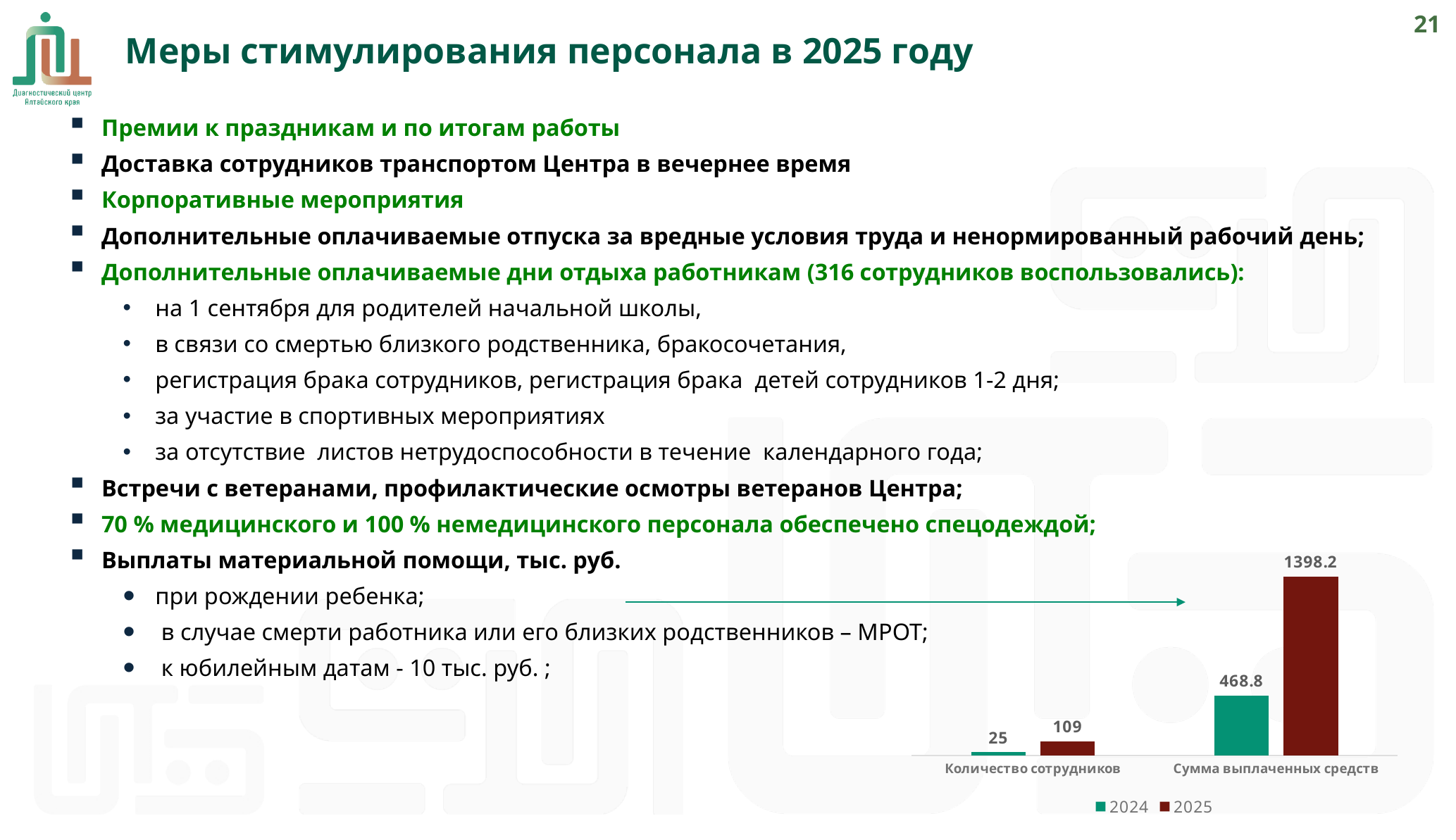
How many series does the chart legend list? 2 Which bar in the chart has the highest value? 2025, Сумма выплаченных средств Which bar in the chart has the lowest value? 2024, Количество сотрудников What is the value for 2024 in the 'Сумма выплаченных средств' category? 468.8 What is the difference between the 2025 and 2024 values for 'Количество сотрудников'? 84 For 'Количество сотрудников', which year has the larger value, 2024 or 2025? 2025 What is the value for 2025 in the 'Количество сотрудников' category? 109 What is the difference between the 2025 and 2024 values for 'Сумма выплаченных средств'? 929.4 What is the value for 2025 in the 'Сумма выплаченных средств' category? 1398.2 What is the value for 2024 in the 'Количество сотрудников' category? 25 What type of chart is shown on the slide? Bar chart How many categories are shown on the x axis of the chart? 2